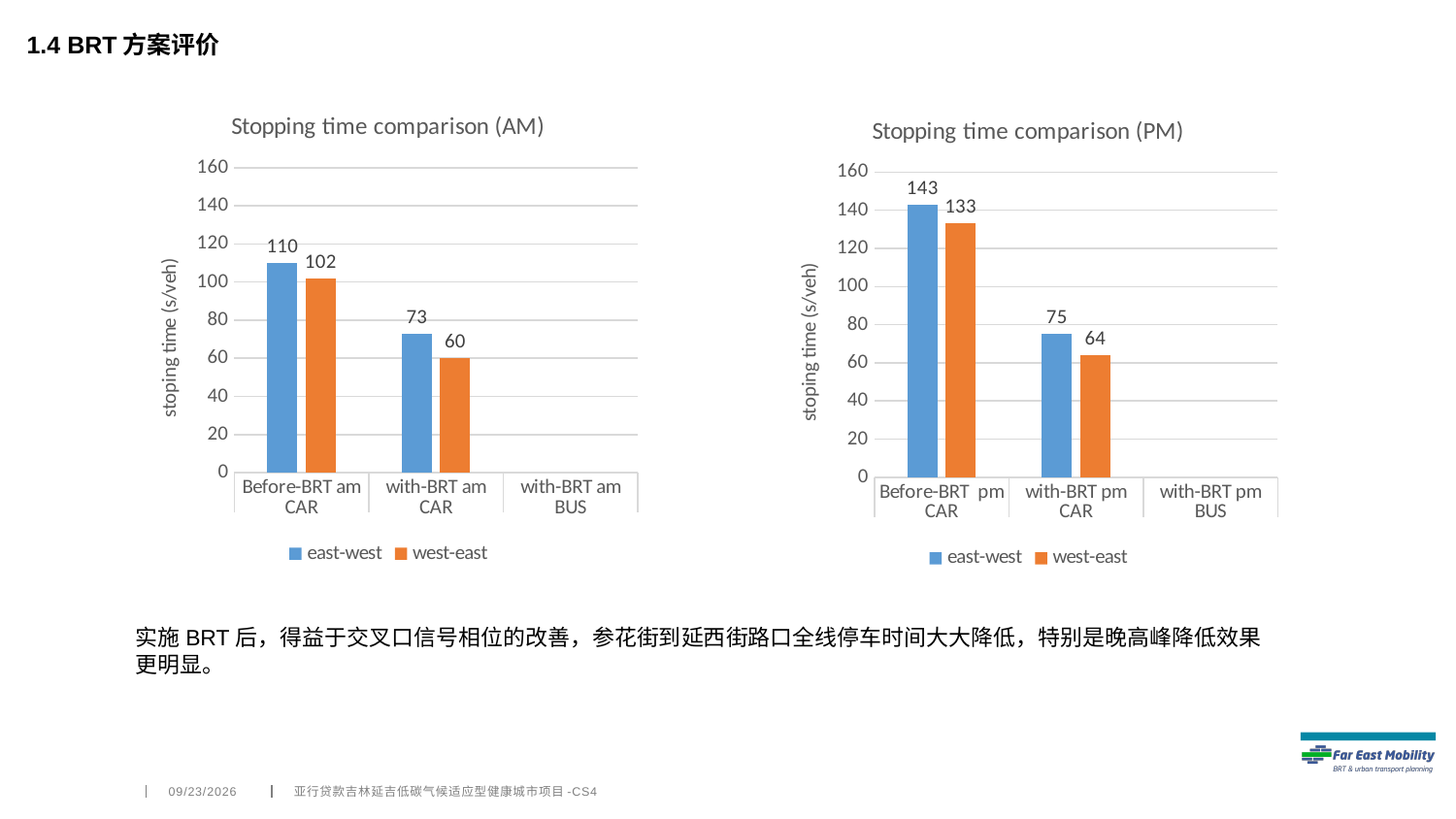
How many series does the legend of the 'Stopping time comparison (AM)' chart list? 2 In the 'Stopping time comparison (PM)' chart, what is the west-east value for with-BRT pm CAR? 64 In the 'Stopping time comparison (PM)' chart, what is the east-west value for Before-BRT pm CAR? 143 In the 'Stopping time comparison (AM)' chart, which is larger: the east-west value for with-BRT am CAR or the west-east value for with-BRT am CAR? east-west What kind of chart is the 'Stopping time comparison (PM)' chart? bar chart In the 'Stopping time comparison (AM)' chart, what is the west-east value for with-BRT am CAR? 60 In the 'Stopping time comparison (AM)' chart, what is the east-west value for Before-BRT am CAR? 110 In the 'Stopping time comparison (PM)' chart, which category has the highest east-west value? Before-BRT pm CAR What is the y-axis label of the 'Stopping time comparison (AM)' chart? stoping time (s/veh) In the 'Stopping time comparison (PM)' chart, what is the difference between the east-west values for Before-BRT pm CAR and with-BRT pm CAR? 68 In the 'Stopping time comparison (AM)' chart, what is the difference between the east-west and west-east values for Before-BRT am CAR? 8 In the 'Stopping time comparison (PM)' chart, is the west-east value for Before-BRT pm CAR greater or less than 120? greater